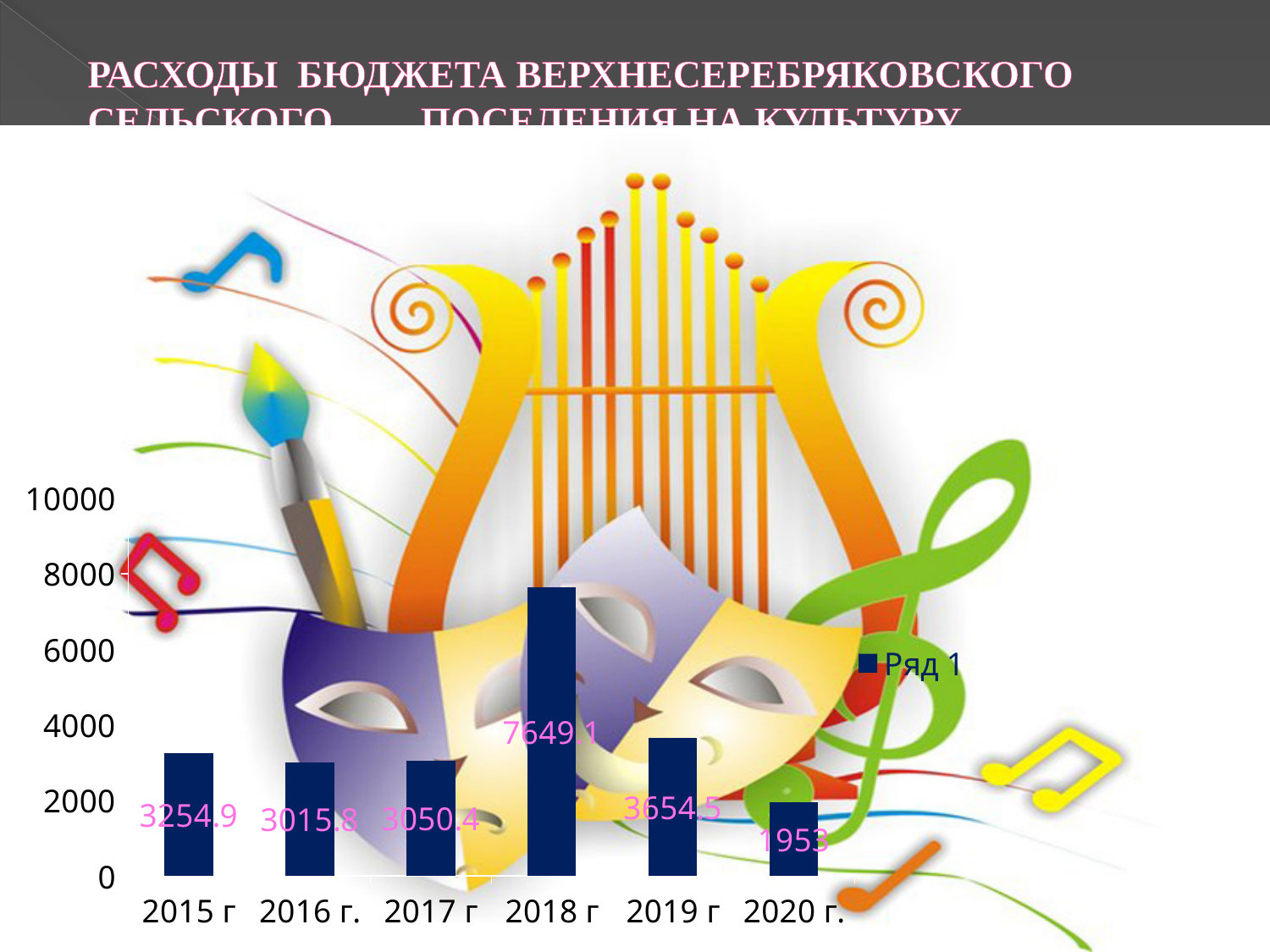
How many series does the legend list? 1 What is the difference between the values for 2018 г and 2019 г? 3994.6 What kind of chart is shown on the slide? bar chart Is the value for 2019 г greater or less than 4000? less Which is larger, the value for 2015 г or the value for 2016 г.? 2015 г How many years are shown on the x axis? 6 Which year has the lowest value? 2020 г. What is the value for 2020 г.? 1953 What is the value for 2015 г? 3254.9 What is the value for 2018 г? 7649.1 Which year has the highest value? 2018 г What is the name of the series in the legend? Ряд 1